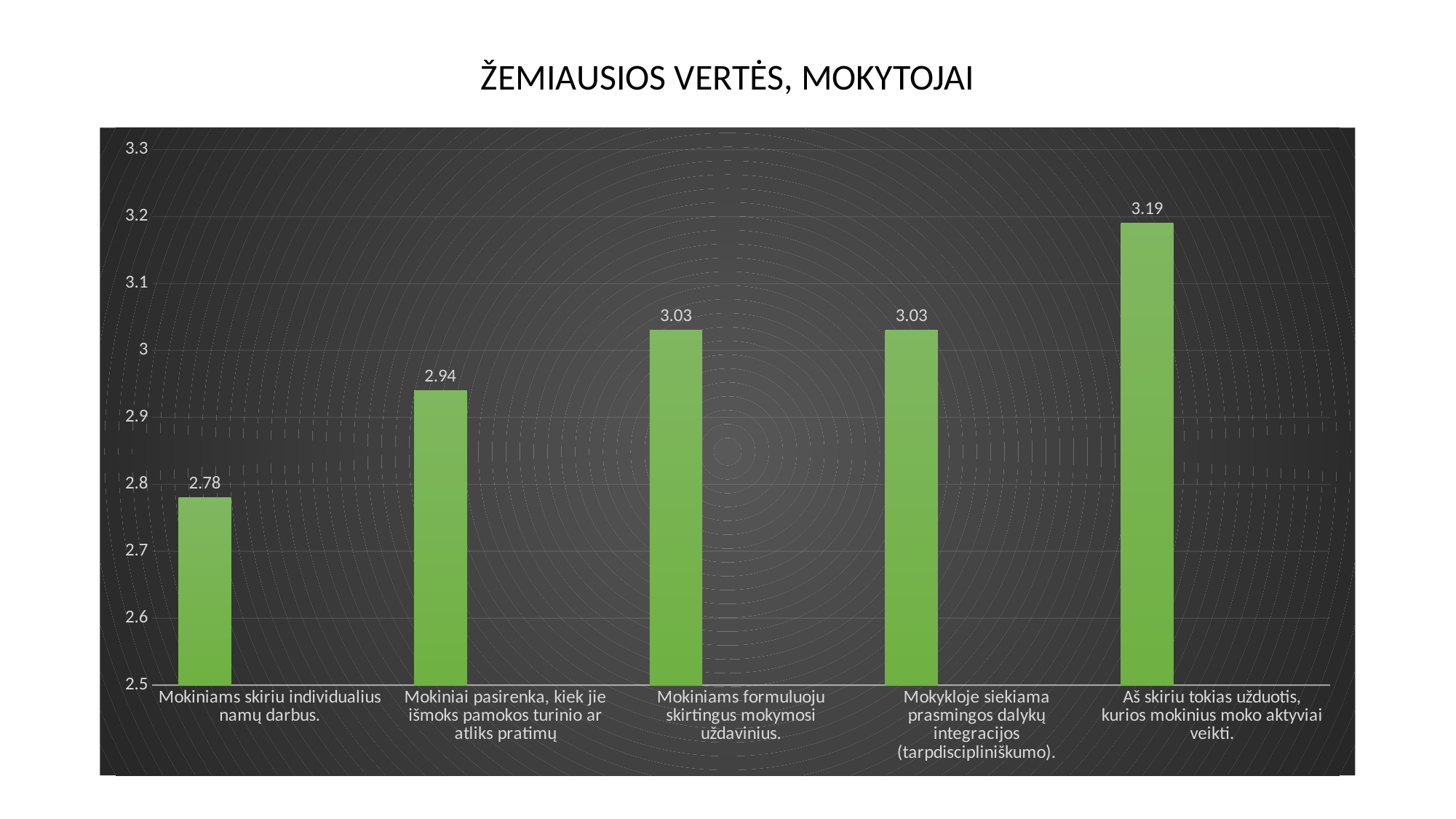
What is the difference between the values for "Mokiniams formuluoju skirtingus mokymosi uždavinius." and "Mokiniai pasirenka, kiek jie išmoks pamokos turinio ar atliks pratimų"? 0.09 What is the value for "Aš skiriu tokias užduotis, kurios mokinius moko aktyviai veikti."? 3.19 What is the value for "Mokiniams skiriu individualius namų darbus."? 2.78 Which is larger: the value for "Mokiniai pasirenka, kiek jie išmoks pamokos turinio ar atliks pratimų" or for "Mokykloje siekiama prasmingos dalykų integracijos (tarpdiscipliniškumo)."? Mokykloje siekiama prasmingos dalykų integracijos (tarpdiscipliniškumo). How many categories are shown in the chart? 5 What is the value for "Mokiniai pasirenka, kiek jie išmoks pamokos turinio ar atliks pratimų"? 2.94 Is the value for "Mokiniams skiriu individualius namų darbus." greater or less than 3? less What is the title of the chart? ŽEMIAUSIOS VERTĖS, MOKYTOJAI Which category has the lowest value? Mokiniams skiriu individualius namų darbus. What is the difference between the highest and lowest values? 0.41 What kind of chart is shown on the slide? bar chart Which category has the highest value? Aš skiriu tokias užduotis, kurios mokinius moko aktyviai veikti.